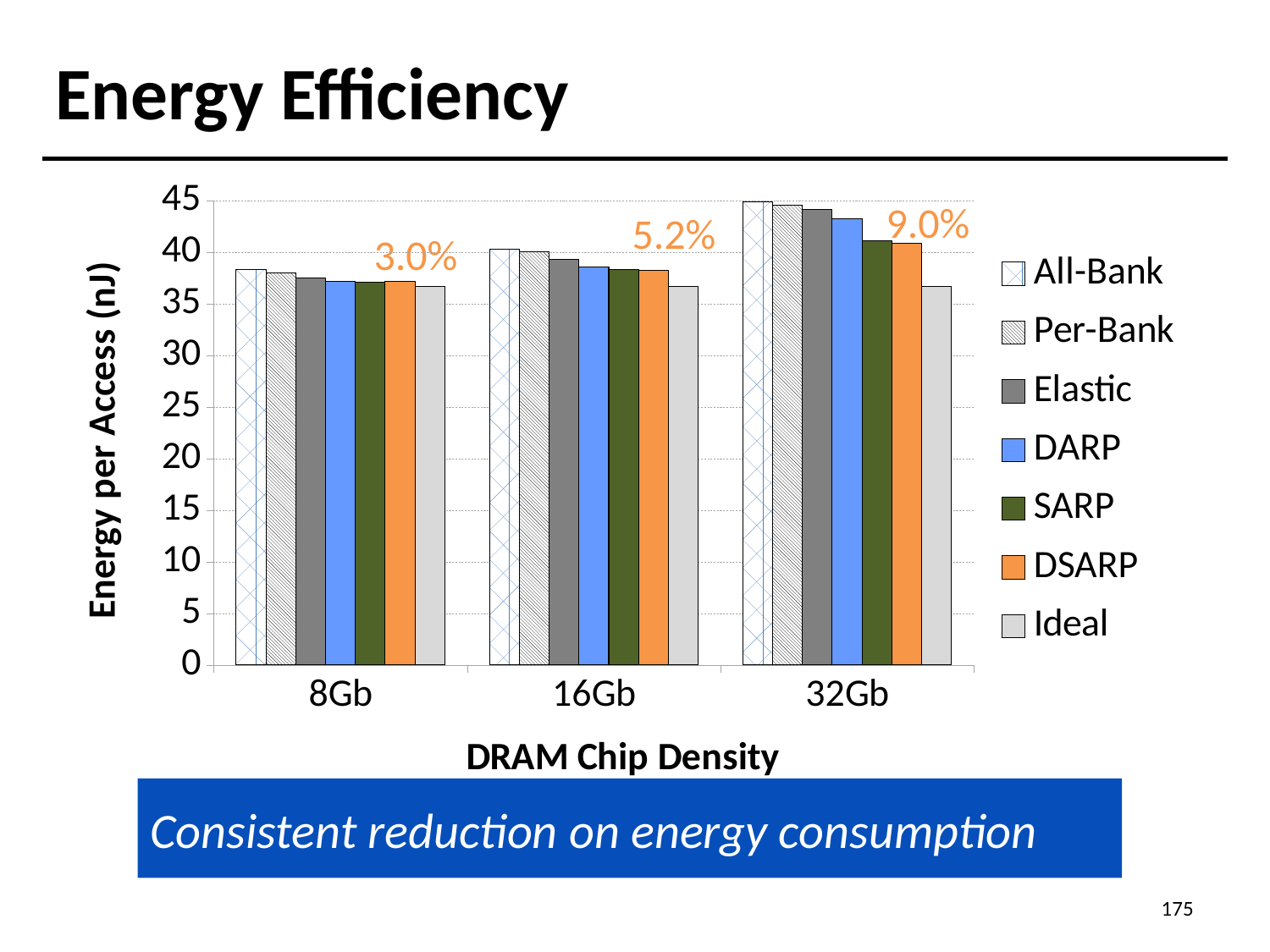
At 32Gb, which is larger: the All-Bank value or the Ideal value? All-Bank How many series does the legend list? 7 Is the value for Ideal at 8Gb greater or less than 40? less How many DRAM chip density categories are shown on the x axis? 3 Which series has the lowest energy per access at 32Gb? Ideal Is the value for DARP at 32Gb greater or less than 40? greater Is the value for All-Bank at 32Gb greater or less than 40? greater What percentage annotation is shown above the 32Gb group? 9.0% For which DRAM chip density is the All-Bank energy per access highest? 32Gb What kind of chart is shown on the slide? bar chart Does the All-Bank energy per access rise or fall as DRAM chip density increases from 8Gb to 32Gb? rise